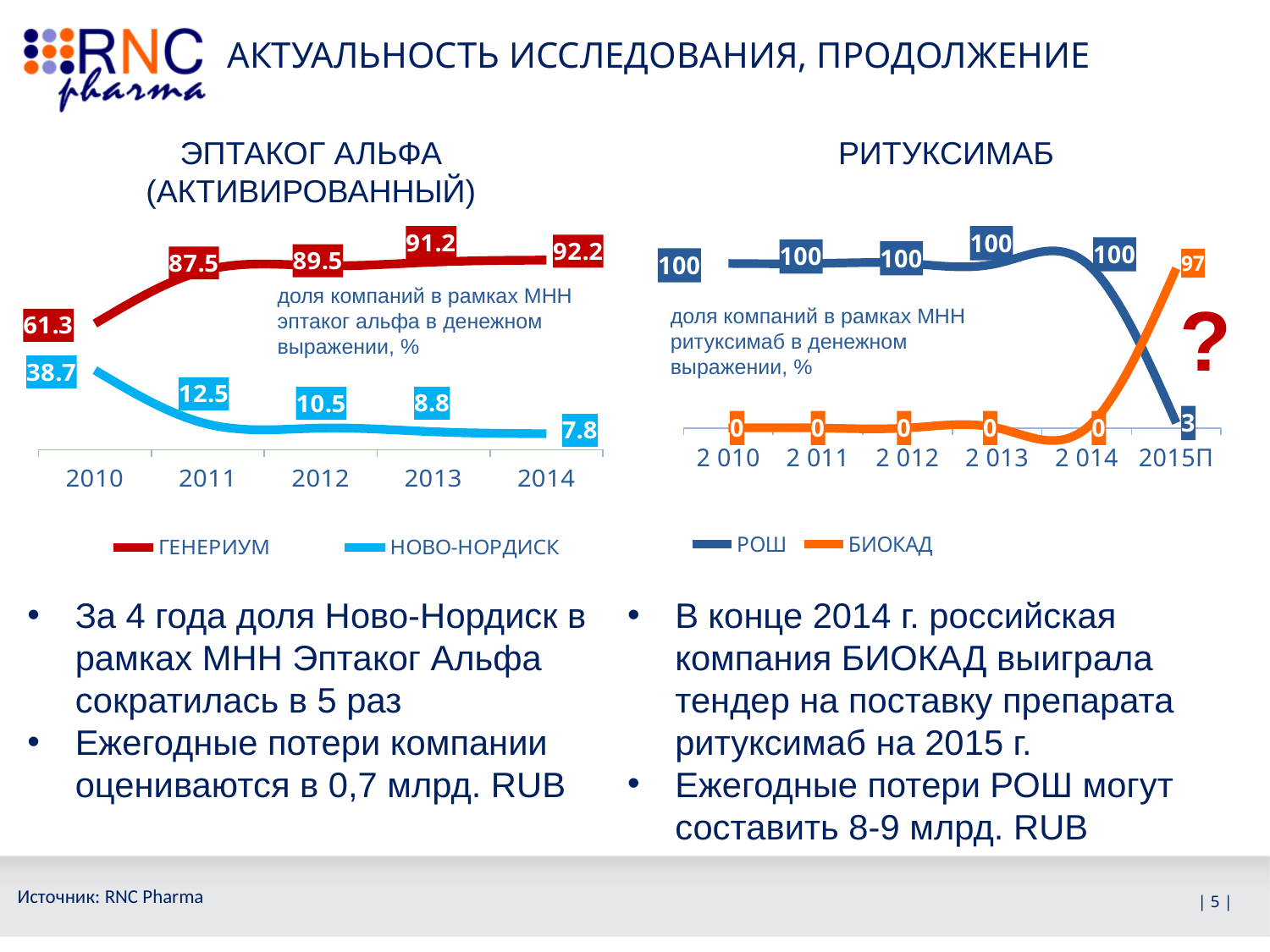
In the ЭПТАКОГ АЛЬФА (АКТИВИРОВАННЫЙ) chart, what is the value for ГЕНЕРИУМ in 2014? 92.2 In the ЭПТАКОГ АЛЬФА (АКТИВИРОВАННЫЙ) chart, what is the value for НОВО-НОРДИСК in 2010? 38.7 In the ЭПТАКОГ АЛЬФА (АКТИВИРОВАННЫЙ) chart, how many years are shown on the x axis? 5 In the РИТУКСИМАБ chart, what is the difference between the РОШ and БИОКАД values in 2013? 100 In the РИТУКСИМАБ chart, what is the value for БИОКАД in 2015П? 97 In the ЭПТАКОГ АЛЬФА (АКТИВИРОВАННЫЙ) chart, what type of chart is used? line chart In the ЭПТАКОГ АЛЬФА (АКТИВИРОВАННЫЙ) chart, in which year is the НОВО-НОРДИСК value lowest? 2014 In the РИТУКСИМАБ chart, what is the value for РОШ in 2015П? 3 In the РИТУКСИМАБ chart, which series has the larger value in 2015П, РОШ or БИОКАД? БИОКАД In the ЭПТАКОГ АЛЬФА (АКТИВИРОВАННЫЙ) chart, does the НОВО-НОРДИСК series rise or fall from 2010 to 2014? fall In the РИТУКСИМАБ chart, how many series does the legend list? 2 In the ЭПТАКОГ АЛЬФА (АКТИВИРОВАННЫЙ) chart, what is the difference between the ГЕНЕРИУМ and НОВО-НОРДИСК values in 2010? 22.6